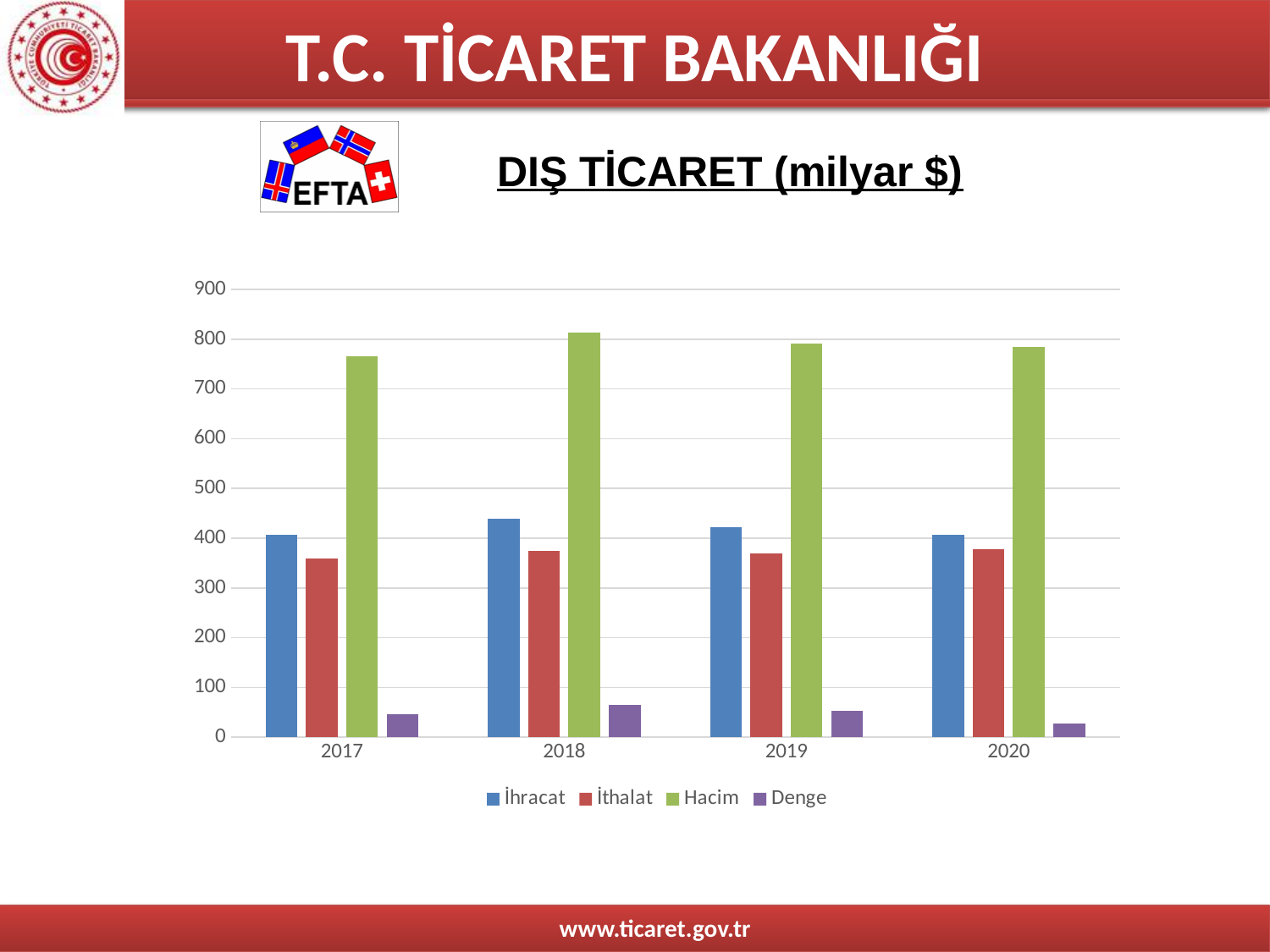
Is the Denge value for 2020 greater or less than 100? less How many series does the legend list? 4 Is the İthalat value for 2017 greater or less than 400? less In which year is the Denge value lowest? 2020 Is the Hacim value for 2018 greater or less than 800? greater How many years are shown on the x axis? 4 In which year is the Hacim value highest? 2018 In 2017, which is larger, İhracat or İthalat? İhracat What kind of chart is shown on the slide? bar chart What is the title of the chart? DIŞ TİCARET (milyar $) In which year is the İhracat value highest? 2018